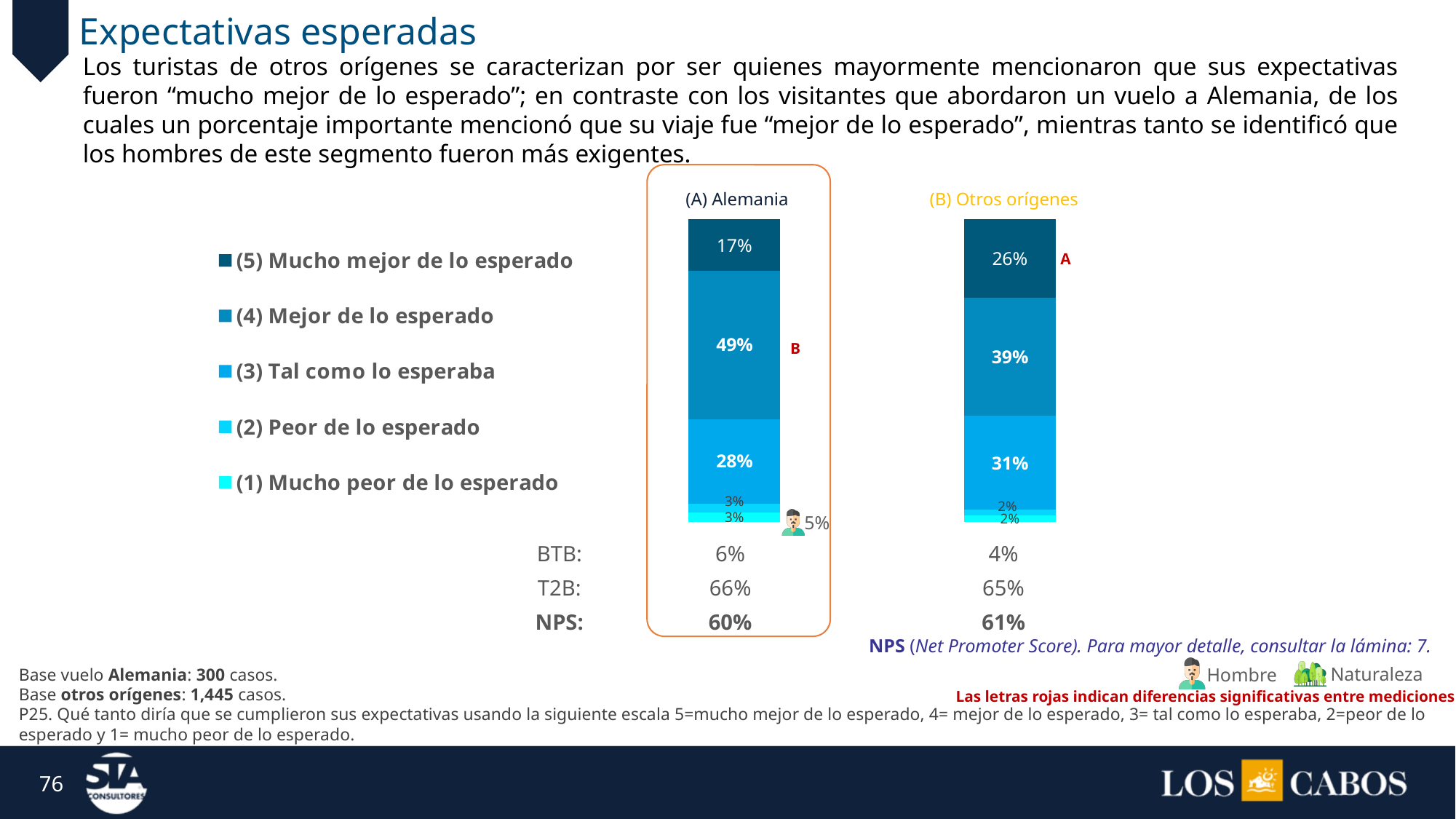
How many series does the legend list? 5 What percentage of (B) Otros orígenes respondents said '(4) Mejor de lo esperado'? 39% Which segment is the largest in the (B) Otros orígenes bar? (4) Mejor de lo esperado What is the value for '(2) Peor de lo esperado' in the (B) Otros orígenes bar? 2% What is the NPS shown for (A) Alemania? 60% What kind of chart is shown on the slide? Stacked bar chart Which bar has the larger value for '(4) Mejor de lo esperado', (A) Alemania or (B) Otros orígenes? (A) Alemania What is the value for '(3) Tal como lo esperaba' in the (A) Alemania bar? 28% How many bars (categories) are plotted in the chart? 2 What is the difference between the '(5) Mucho mejor de lo esperado' values for (B) Otros orígenes and (A) Alemania? 9% What percentage of (A) Alemania respondents said '(5) Mucho mejor de lo esperado'? 17% What is the value for '(5) Mucho mejor de lo esperado' in the (B) Otros orígenes bar? 26%